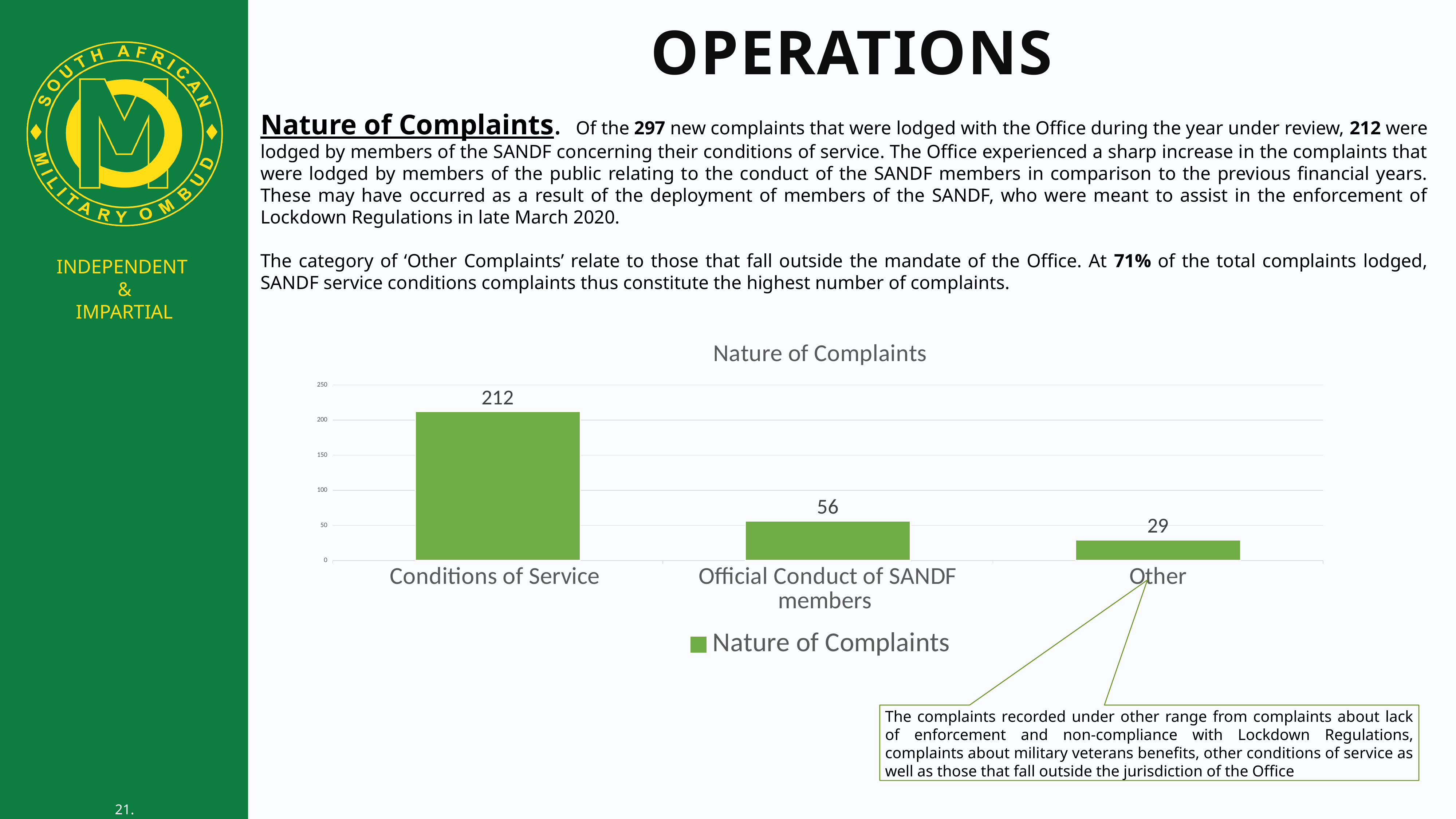
What kind of chart is shown on the slide? bar chart Which category has the lowest value? Other Is the value for Conditions of Service greater or less than 200? greater Which is larger, the value for Official Conduct of SANDF members or the value for Other? Official Conduct of SANDF members What is the difference between the values for Conditions of Service and Official Conduct of SANDF members? 156 What is the difference between the values for Official Conduct of SANDF members and Other? 27 What is the value for Conditions of Service? 212 What is the title of the chart? Nature of Complaints Which category has the highest value? Conditions of Service What is the value for Official Conduct of SANDF members? 56 What is the value for Other? 29 How many categories are shown in the chart? 3